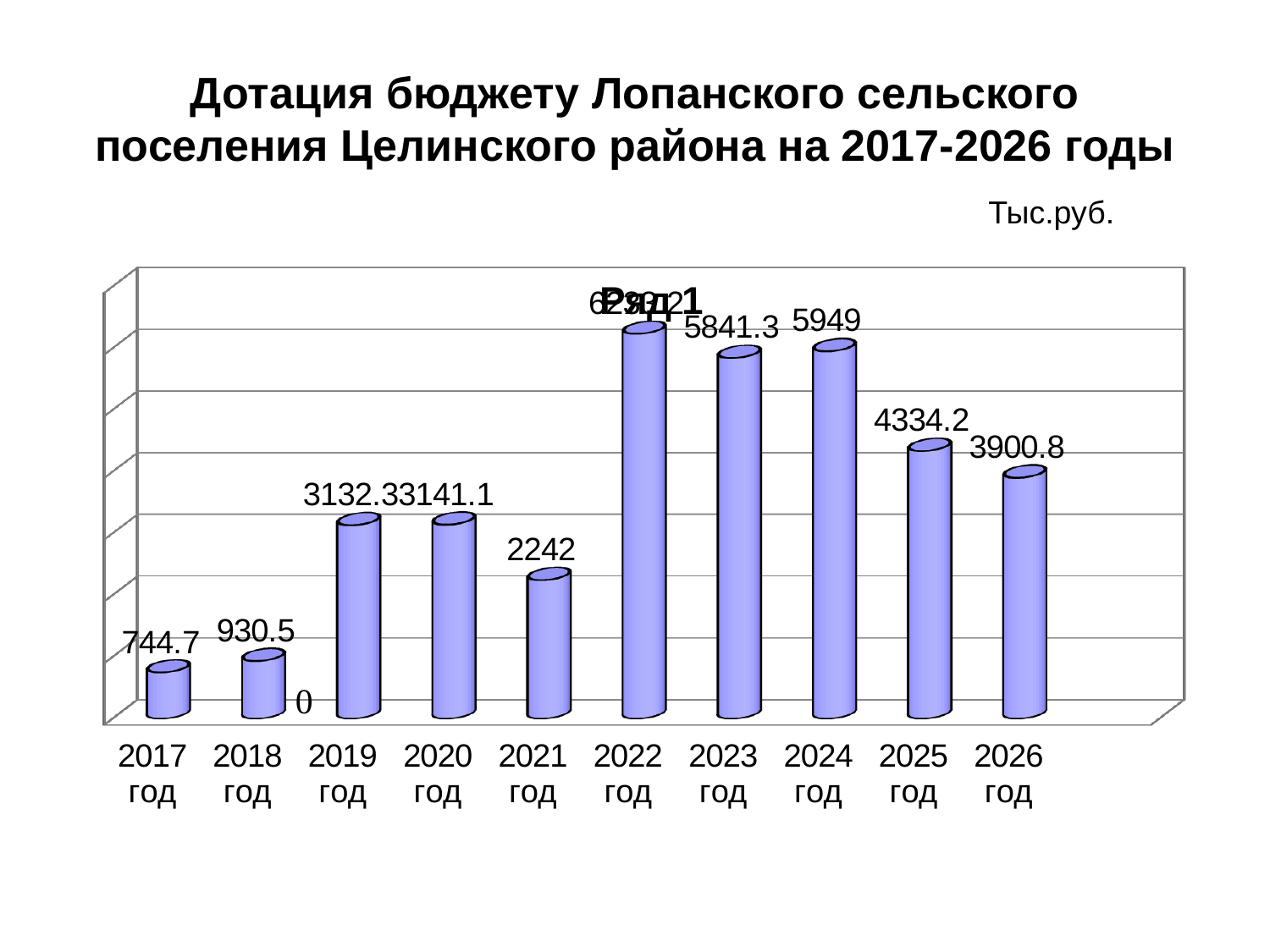
What is the value for 2017 год? 744.7 What is the difference between the values for 2024 год and 2023 год? 107.7 What is the value for 2026 год? 3900.8 How many years are shown on the x axis? 10 What is the value for 2021 год? 2242 Which year has the highest value? 2022 год Which year has the lowest value? 2017 год Which is larger, the value for 2025 год or 2026 год? 2025 год What is the value for 2024 год? 5949 What is the value for 2023 год? 5841.3 What is the value for 2025 год? 4334.2 What kind of chart is shown on the slide? bar chart